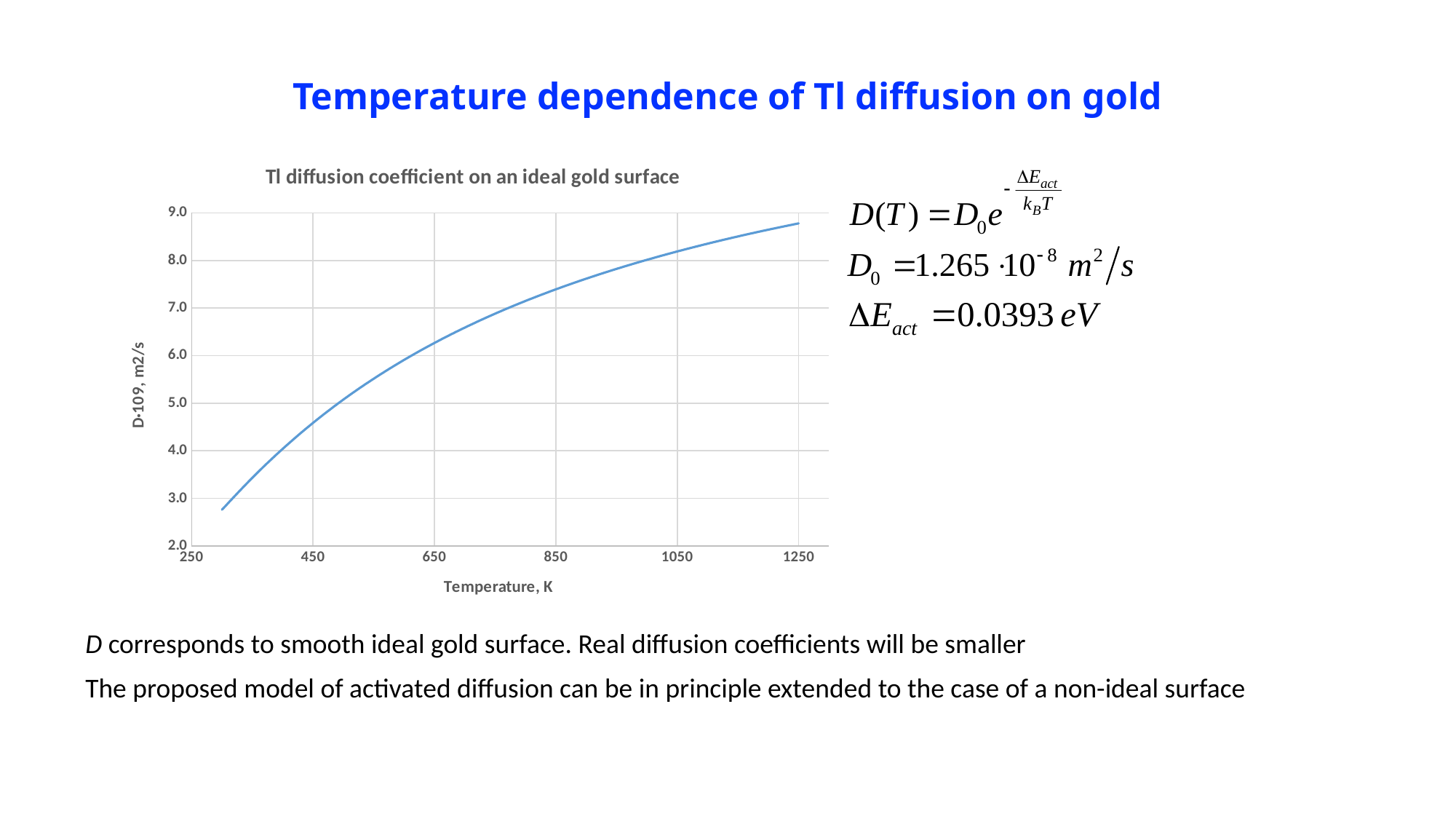
Does the Tl diffusion coefficient rise or fall as temperature increases along the x axis? rise Is the value of the diffusion coefficient at 650 K greater or less than 6.0? greater Is the value of the diffusion coefficient at 1250 K greater or less than 9.0? less At which end of the temperature range is the diffusion coefficient lowest, the low-temperature end or the high-temperature end? low-temperature end Is the value of the diffusion coefficient at 450 K greater or less than 4.0? greater What kind of chart is shown on the slide? line chart What is the title of the chart? Tl diffusion coefficient on an ideal gold surface Which temperature has the larger diffusion coefficient, 450 K or 1250 K? 1250 K What is the label of the x axis of the chart? Temperature, K